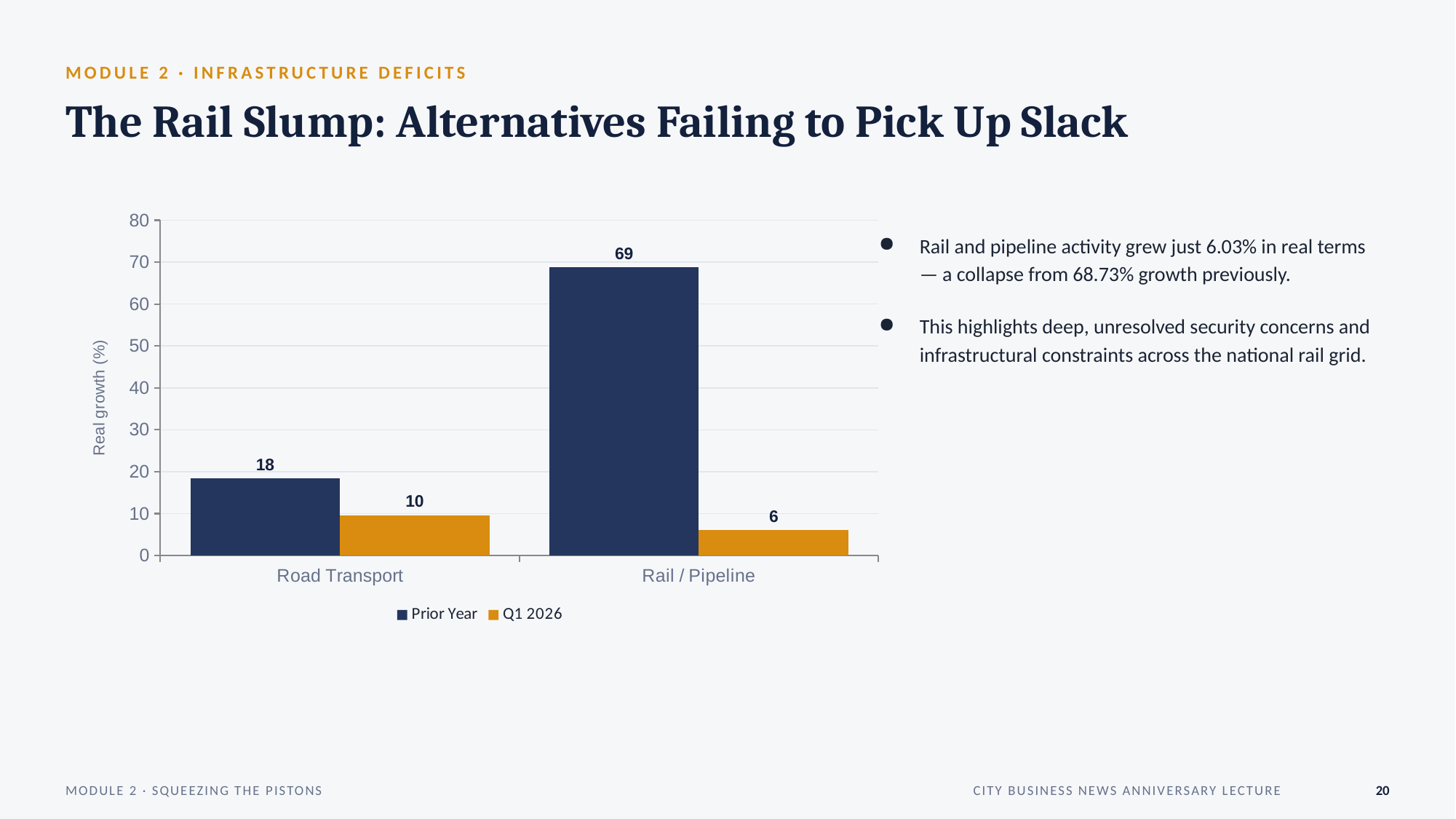
What is the difference between the Prior Year and Q1 2026 values for Rail / Pipeline? 63 Which category has the highest Prior Year value? Rail / Pipeline How many series does the legend list? 2 What is the Q1 2026 value for Rail / Pipeline? 6 Which is larger for Road Transport: the Prior Year value or the Q1 2026 value? Prior Year Which category has the lowest Q1 2026 value? Rail / Pipeline What is the Prior Year value for Road Transport? 18 What is the Prior Year value for Rail / Pipeline? 69 What is the label of the y axis? Real growth (%) What kind of chart is shown on the slide? Bar chart What is the Q1 2026 value for Road Transport? 10 How many categories are shown on the x axis? 2